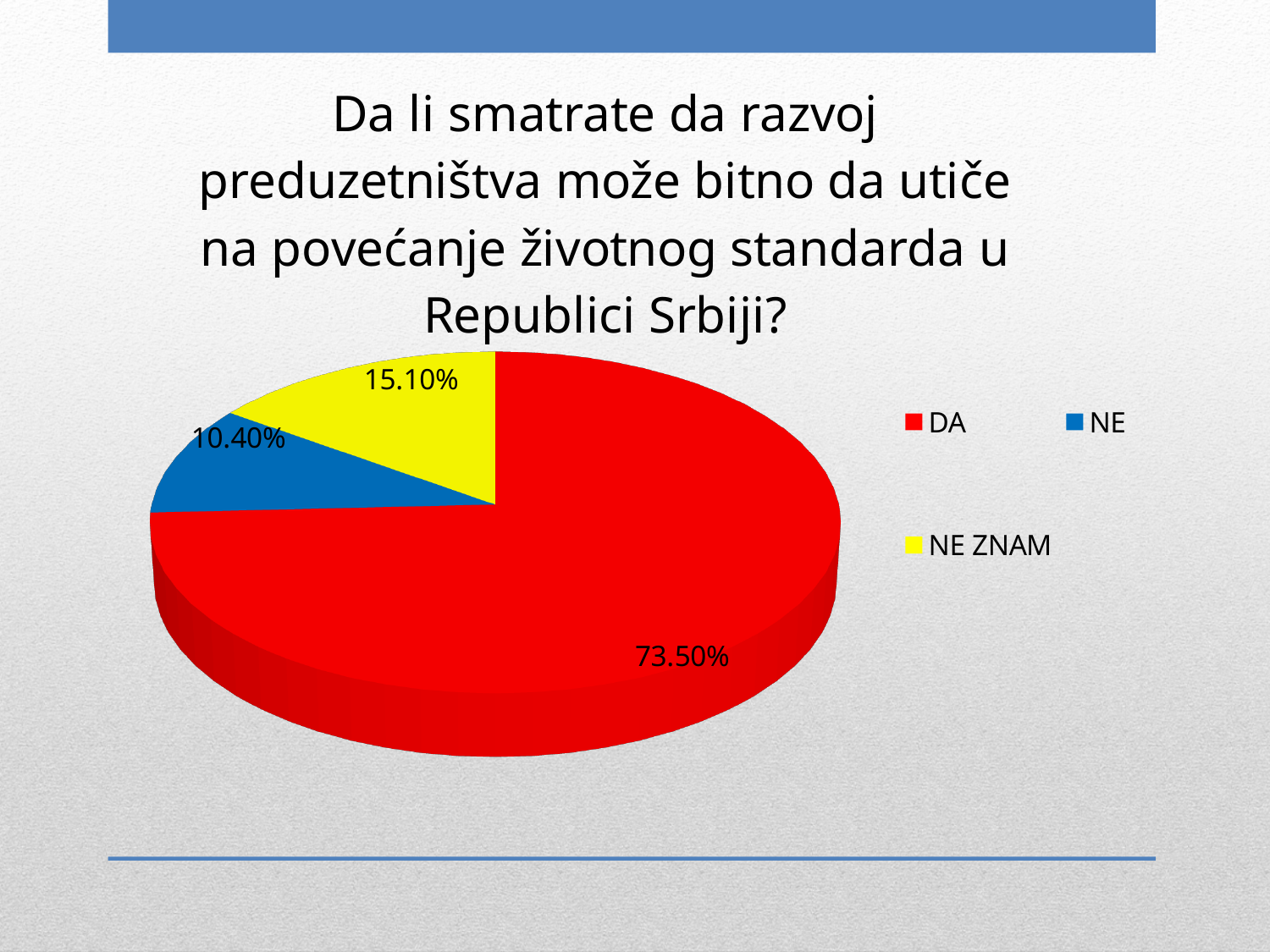
What is the difference in percentage points between DA and NE ZNAM? 58.40 What percentage of respondents answered NE ZNAM? 15.10% How many slices does the pie chart have? 3 What percentage of respondents answered DA? 73.50% What colour is the slice for DA? red How many entries does the legend list? 3 What percentage of respondents answered NE? 10.40% What kind of chart is shown on the slide? pie chart What is the difference in percentage points between NE ZNAM and NE? 4.70 Which response has the smallest share of the pie? NE Which is larger, the share for NE or the share for NE ZNAM? NE ZNAM Which response has the largest share of the pie? DA